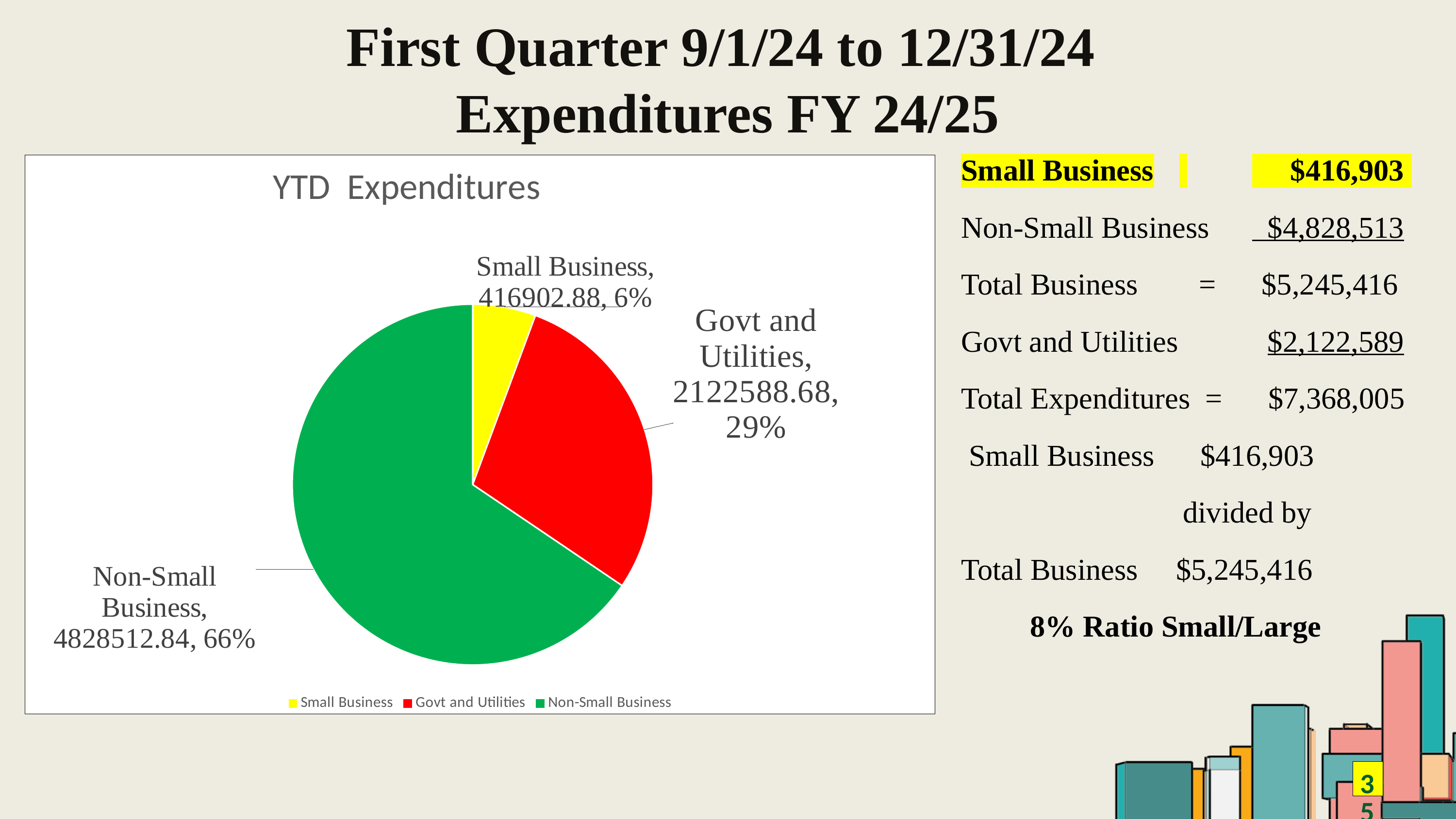
What is the difference between the Non-Small Business value and the Govt and Utilities value in the pie chart? 2705924.16 How many slices does the pie chart have? 3 Which is larger in the pie chart, Govt and Utilities or Small Business? Govt and Utilities What type of chart is shown on the slide? Pie chart What is the value shown for Non-Small Business in the pie chart? 4828512.84 What share of the pie does Non-Small Business represent? 66% What is the title of the chart? YTD Expenditures What is the value shown for Small Business in the pie chart? 416902.88 What share of the pie does Govt and Utilities represent? 29% Which category has the smallest slice in the pie chart? Small Business Which category has the largest slice in the pie chart? Non-Small Business What is the value shown for Govt and Utilities in the pie chart? 2122588.68